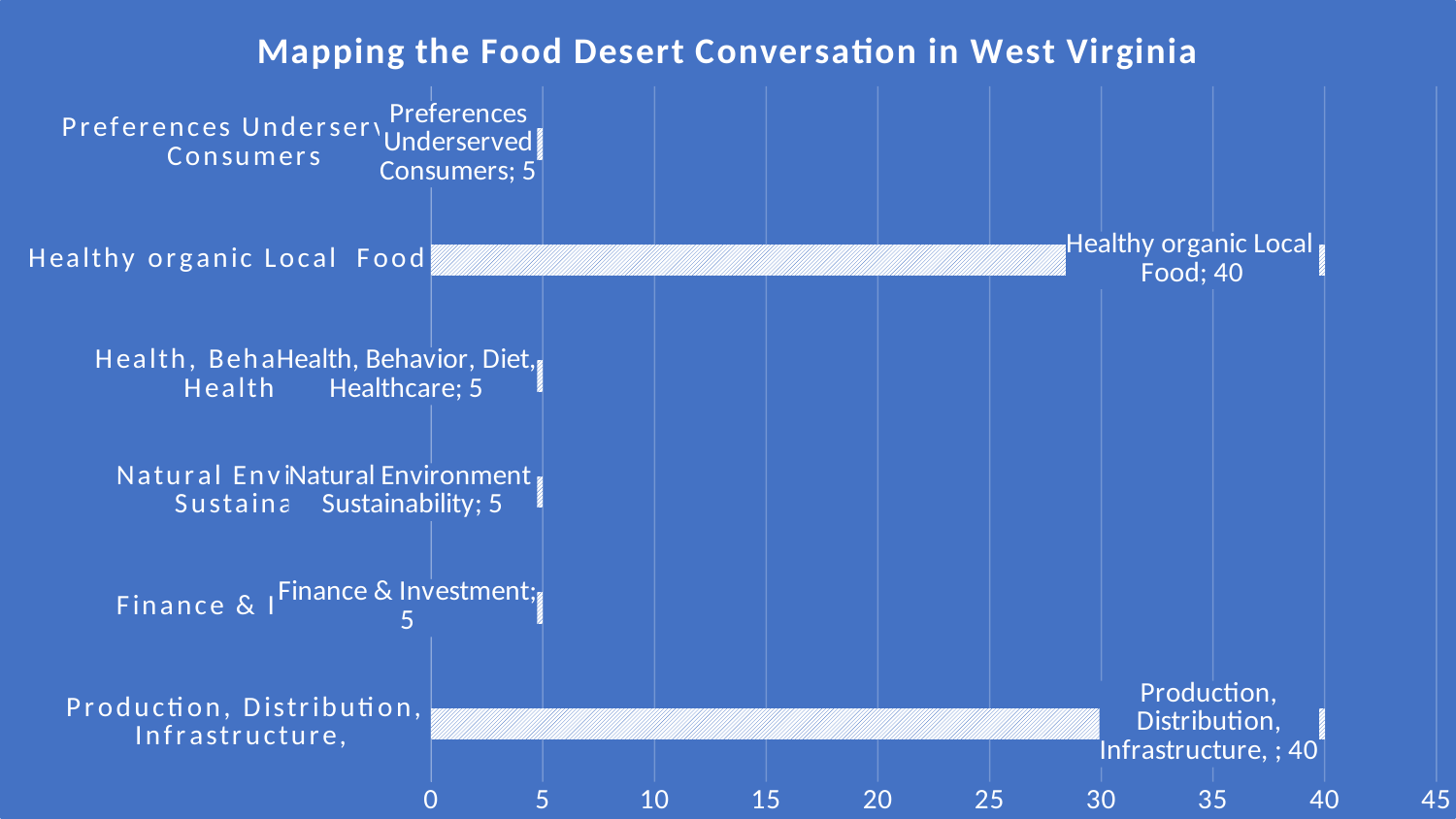
Which is larger, the value for Production, Distribution, Infrastructure or the value for Finance & Investment? Production, Distribution, Infrastructure What is the value for Healthy organic Local Food? 40 What kind of chart is shown on the slide? Bar chart What is the value for Production, Distribution, Infrastructure? 40 What is the title of the chart? Mapping the Food Desert Conversation in West Virginia What is the value for Preferences Underserved Consumers? 5 Is the value for Natural Environment Sustainability greater or less than 10? less What is the value for Finance & Investment? 5 What is the value for Natural Environment Sustainability? 5 Is the value for Healthy organic Local Food greater or less than 30? greater How many categories are shown in the chart? 6 What is the difference between the values for Healthy organic Local Food and Health, Behavior, Diet, Healthcare? 35